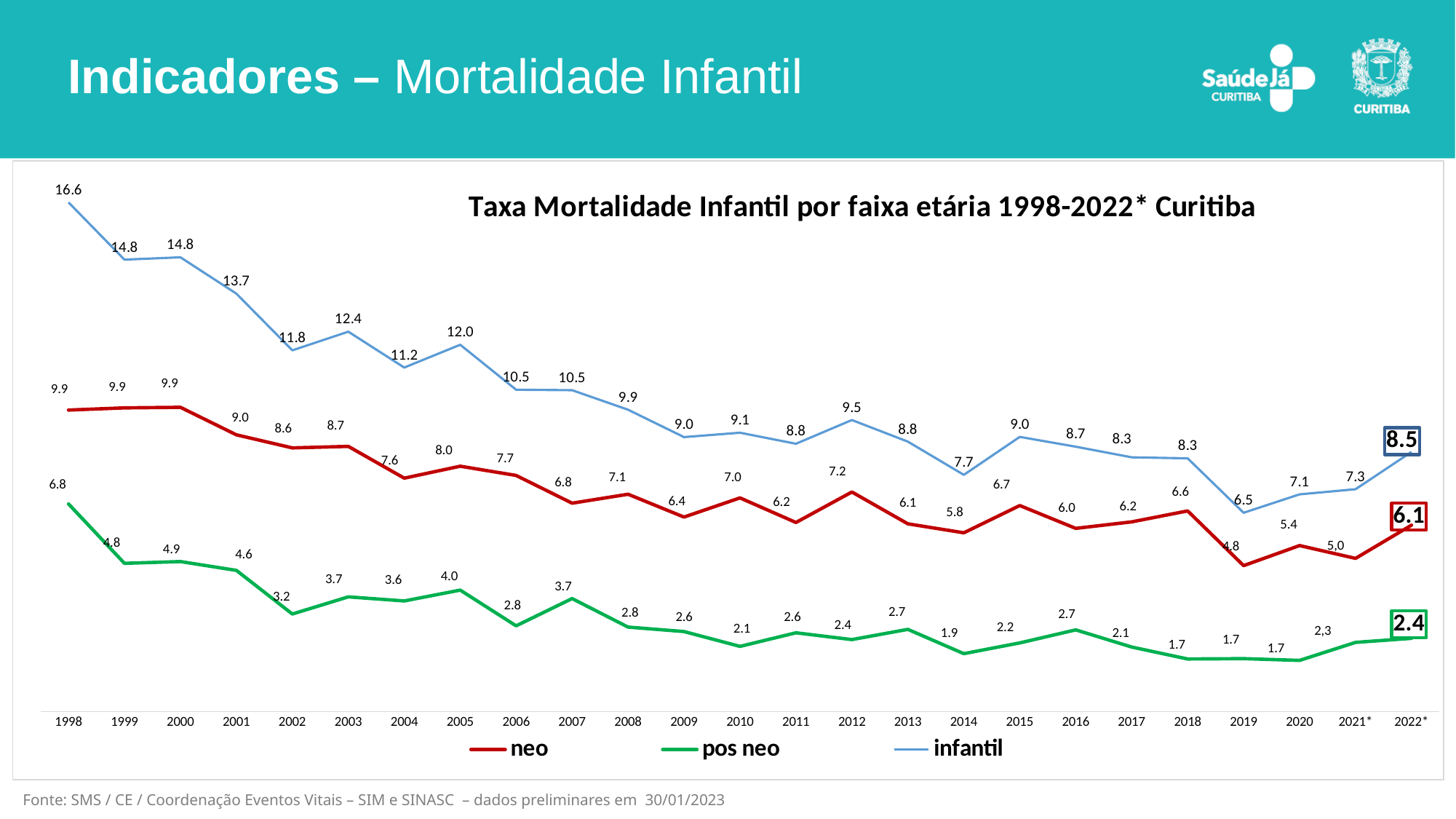
In which year is the infantil series at its highest? 1998 Does the infantil series generally rise or fall from 1998 to 2022*? fall What is the neo value for 2022*? 6.1 What kind of chart is shown on the slide? line chart What is the infantil value for 2019? 6.5 How many years are shown on the x axis? 25 What is the pos neo value for 2014? 1.9 How many series does the legend list? 3 Which is larger, the neo value for 2012 or the neo value for 2013? 2012 What is the difference between the infantil values for 1998 and 2022*? 8.1 In which year is the neo series at its lowest? 2019 What is the infantil value for 1998? 16.6